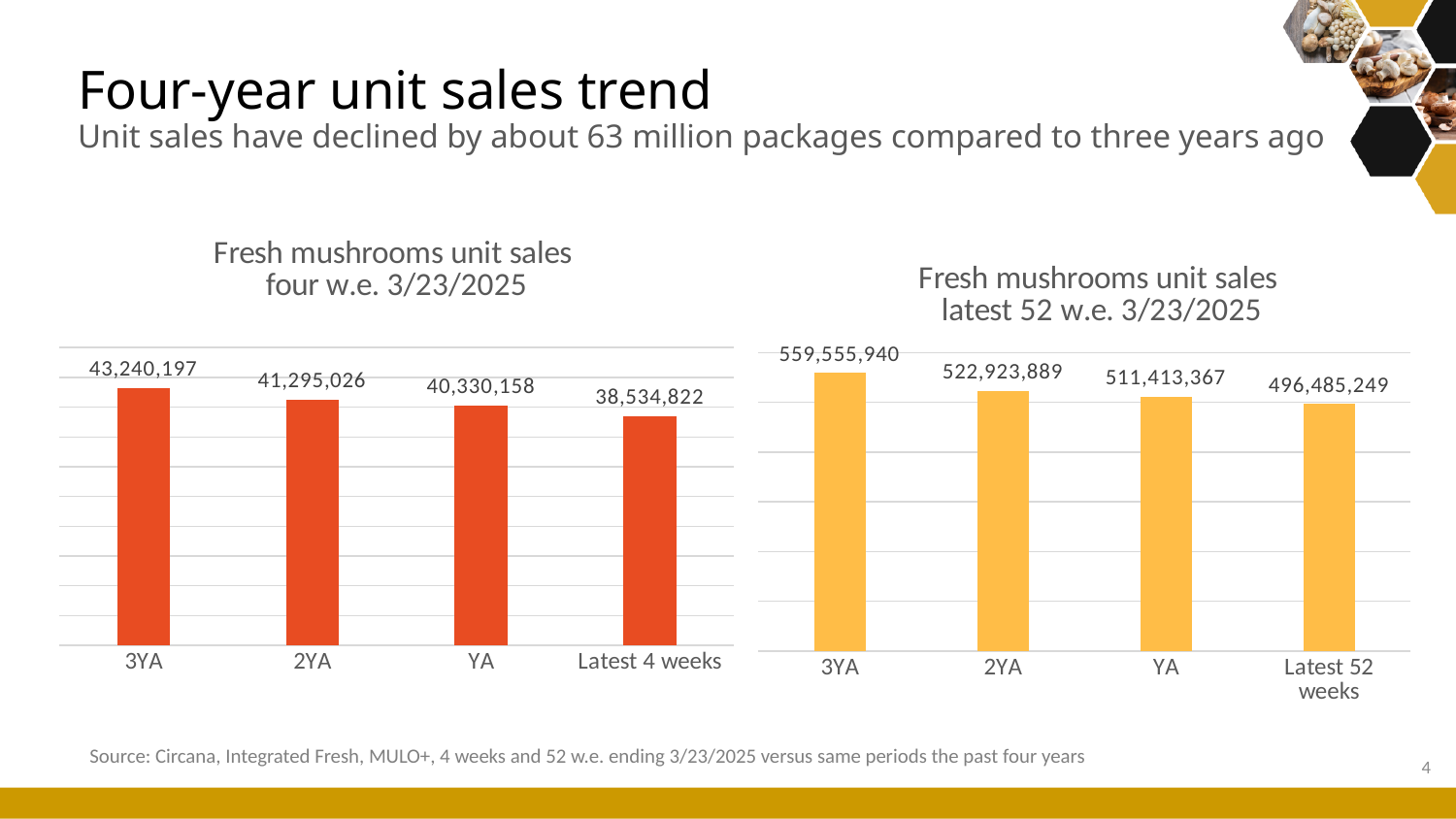
In the 'Fresh mushrooms unit sales latest 52 w.e. 3/23/2025' chart, which period has the highest value? 3YA In the 'Fresh mushrooms unit sales four w.e. 3/23/2025' chart, what is the value for Latest 4 weeks? 38,534,822 In the 'Fresh mushrooms unit sales latest 52 w.e. 3/23/2025' chart, what is the value for 2YA? 522,923,889 In the 'Fresh mushrooms unit sales latest 52 w.e. 3/23/2025' chart, what is the value for Latest 52 weeks? 496,485,249 In the 'Fresh mushrooms unit sales four w.e. 3/23/2025' chart, which period has the lowest value? Latest 4 weeks In the 'Fresh mushrooms unit sales latest 52 w.e. 3/23/2025' chart, what is the difference between the 3YA value and the Latest 52 weeks value? 63,070,691 In the 'Fresh mushrooms unit sales four w.e. 3/23/2025' chart, which is larger, the value for 2YA or the value for YA? 2YA What kind of chart is the 'Fresh mushrooms unit sales four w.e. 3/23/2025' chart? Bar chart In the 'Fresh mushrooms unit sales latest 52 w.e. 3/23/2025' chart, do the values rise or fall from 3YA to Latest 52 weeks? Fall How many periods are shown on the x axis of the 'Fresh mushrooms unit sales latest 52 w.e. 3/23/2025' chart? 4 In the 'Fresh mushrooms unit sales four w.e. 3/23/2025' chart, what is the difference between the 3YA value and the Latest 4 weeks value? 4,705,375 In the 'Fresh mushrooms unit sales four w.e. 3/23/2025' chart, what is the value for 3YA? 43,240,197